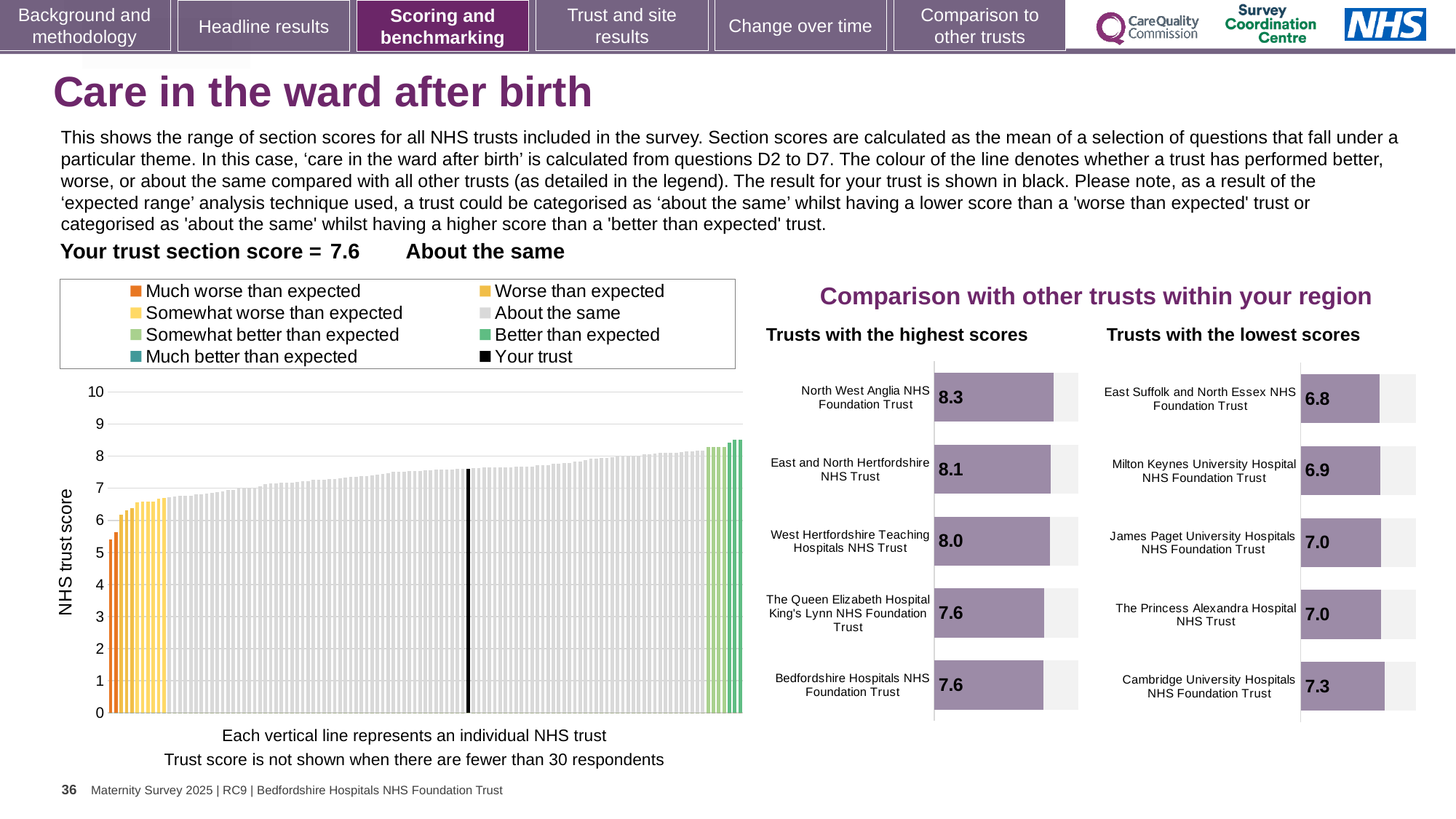
In the 'Trusts with the lowest scores' chart, which has the larger score: Milton Keynes University Hospital NHS Foundation Trust or Cambridge University Hospitals NHS Foundation Trust? Cambridge University Hospitals NHS Foundation Trust In the 'Trusts with the highest scores' chart, what is the score for North West Anglia NHS Foundation Trust? 8.3 In the main NHS trust score chart, what is the section score for your trust (the black bar)? 7.6 In the 'Trusts with the highest scores' chart, what is the difference between the scores of North West Anglia NHS Foundation Trust and Bedfordshire Hospitals NHS Foundation Trust? 0.7 In the 'Trusts with the highest scores' chart, how many trusts are shown? 5 In the main NHS trust score chart, do the values rise or fall from left to right along the x axis? rise In the 'Trusts with the highest scores' chart, which trust has the highest score? North West Anglia NHS Foundation Trust How many entries does the legend above the main NHS trust score chart list? 8 In the main NHS trust score chart, is the value of the lowest (leftmost) bar greater or less than 6? less What kind of chart is the main NHS trust score chart? bar chart In the 'Trusts with the lowest scores' chart, which trust has the lowest score? East Suffolk and North Essex NHS Foundation Trust In the 'Trusts with the lowest scores' chart, what is the score for Cambridge University Hospitals NHS Foundation Trust? 7.3